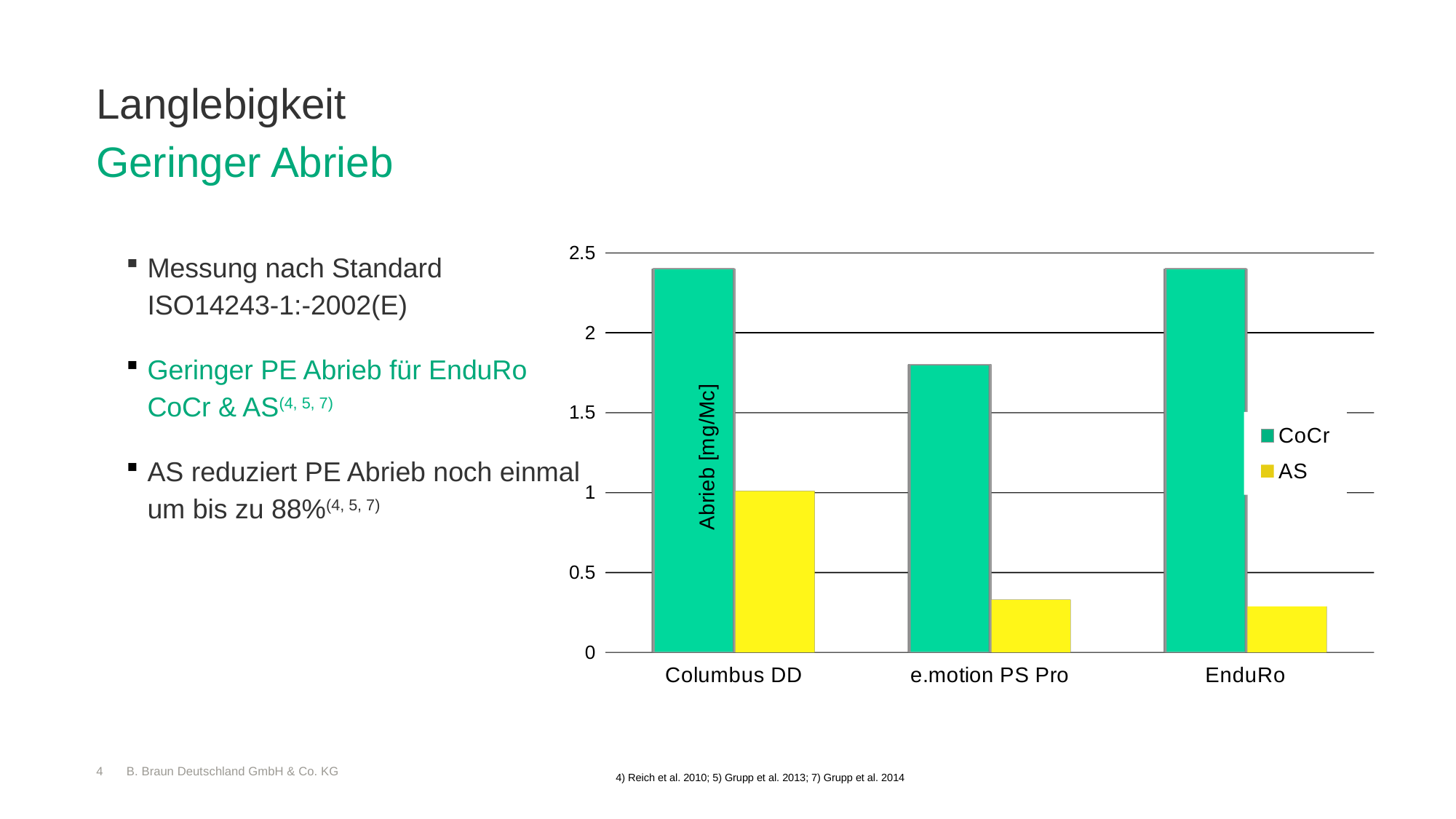
Is the CoCr value for Columbus DD greater or less than 2? greater Is the CoCr value for e.motion PS Pro greater or less than 2? less Which is larger for EnduRo, the CoCr value or the AS value? CoCr Is the AS value for EnduRo greater or less than 0.5? less How many categories are shown on the x axis? 3 Which category has the highest AS value? Columbus DD What is the label of the y axis? Abrieb [mg/Mc] Which is larger, the AS value for Columbus DD or the AS value for EnduRo? Columbus DD How many series does the legend list? 2 What kind of chart is shown on the slide? bar chart Which category has the lowest CoCr value? e.motion PS Pro